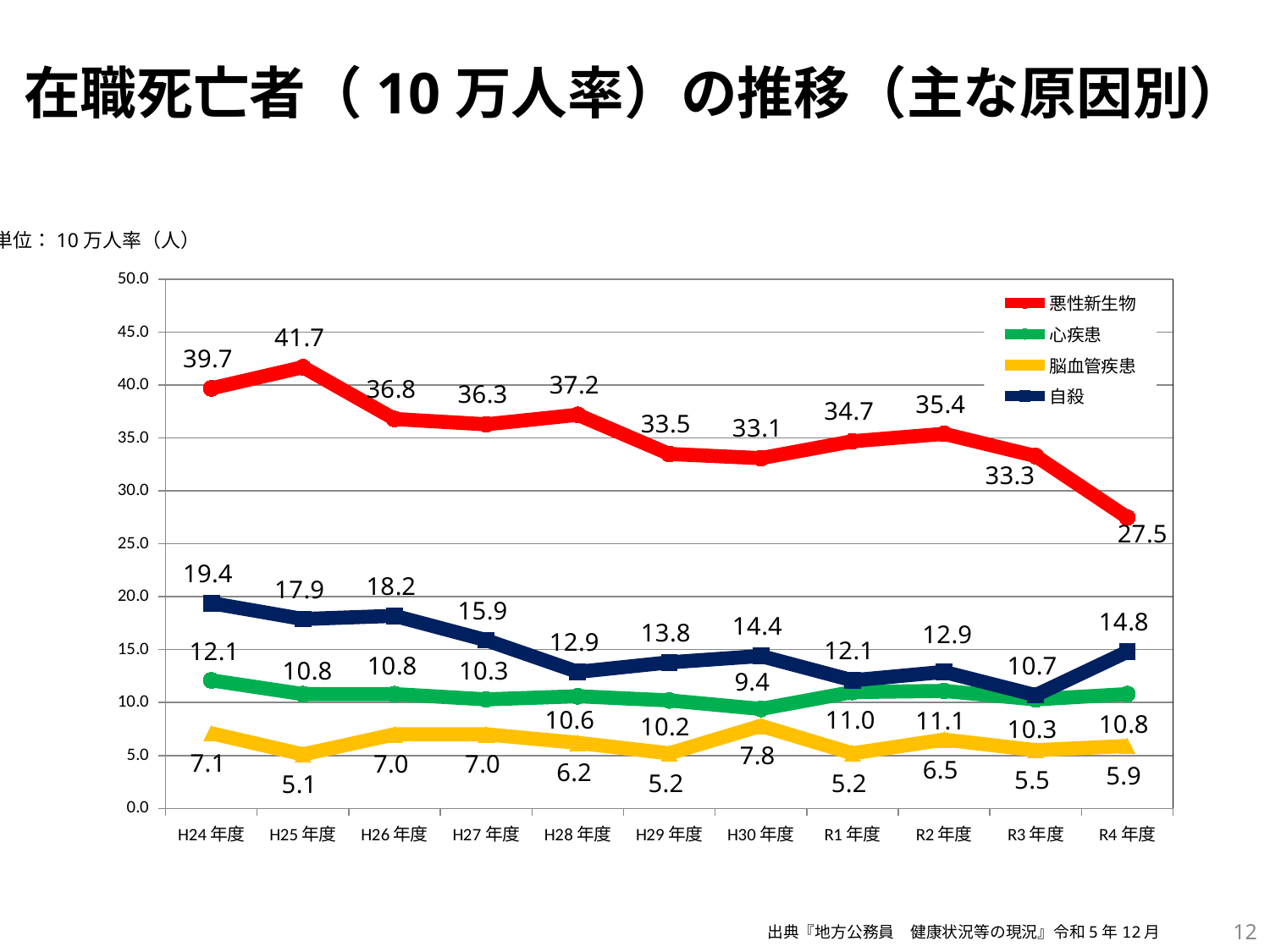
What is the value for 悪性新生物 in H25年度? 41.7 In which fiscal year is the value for 悪性新生物 the lowest? R4年度 In which fiscal year is the value for 悪性新生物 the highest? H25年度 What is the difference between the 自殺 values in H24年度 and R4年度? 4.6 Which is larger in H30年度, the value for 心疾患 or the value for 脳血管疾患? 心疾患 Is the value for 悪性新生物 in R4年度 greater or less than 30.0? less What type of chart is shown on the slide? line chart What is the value for 脳血管疾患 in H30年度? 7.8 Which colour is used for the 自殺 series? navy blue How many series does the legend list? 4 What is the value for 自殺 in R4年度? 14.8 How many fiscal years are plotted along the x axis? 11